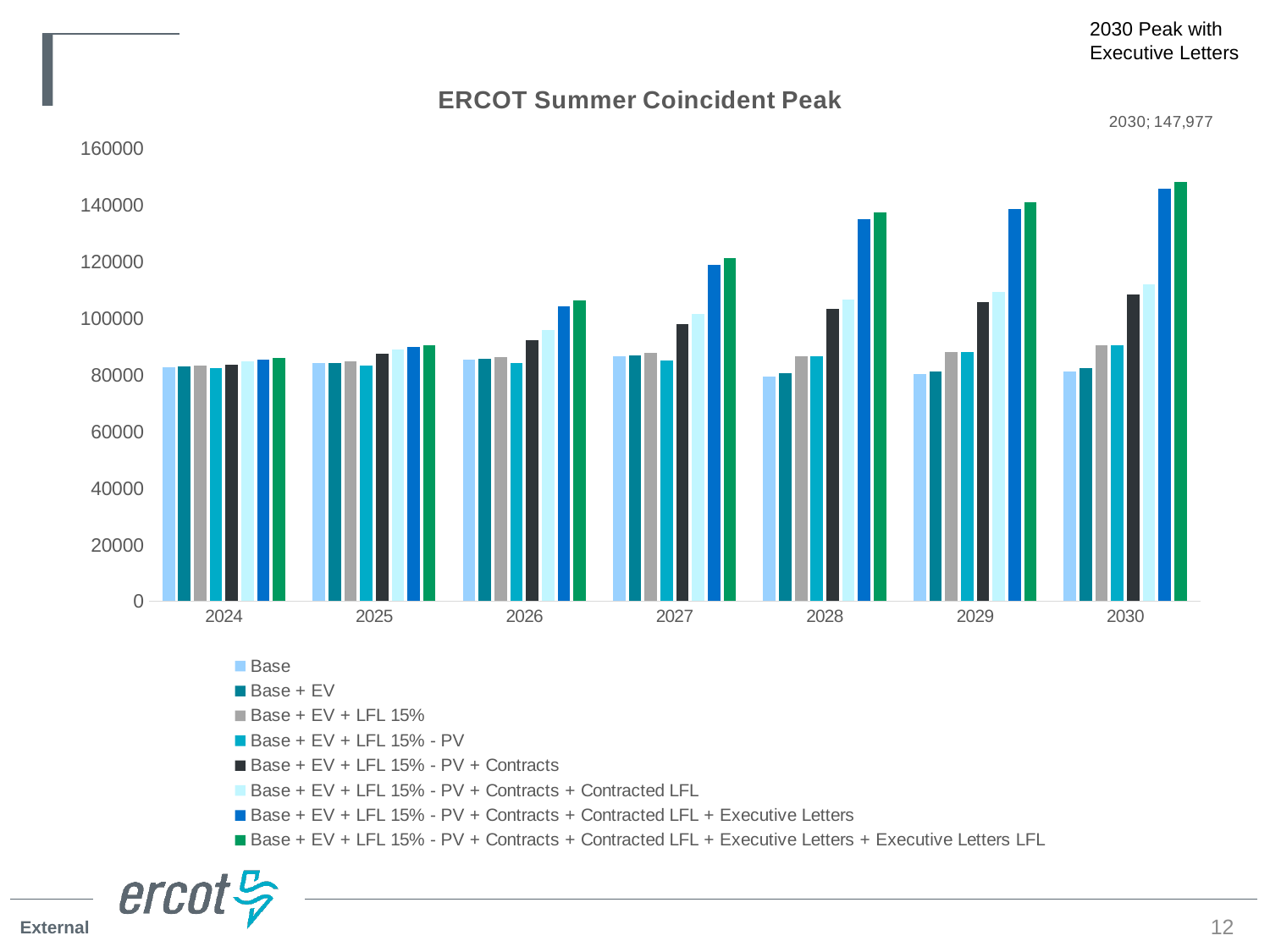
Is the value for the Base series in 2024 greater or less than 100000? less How many series does the chart's legend list? 8 Is the value for 'Base + EV + LFL 15% - PV + Contracts' in 2027 greater or less than 80000? greater What value is printed as a data label for 2030 on the chart? 147,977 In 2028, which is larger: the Base series or the 'Base + EV + LFL 15% - PV + Contracts' series? Base + EV + LFL 15% - PV + Contracts What is the title of the chart? ERCOT Summer Coincident Peak How many years are shown on the x axis of the chart? 7 Which year has the tallest bar in the chart? 2030 Is the value for 'Base + EV + LFL 15% - PV + Contracts + Contracted LFL + Executive Letters + Executive Letters LFL' in 2030 greater or less than 140000? greater Does the 'Base + EV + LFL 15% - PV + Contracts + Contracted LFL + Executive Letters + Executive Letters LFL' series rise or fall from 2024 to 2030? rise What kind of chart is shown on the slide? bar chart